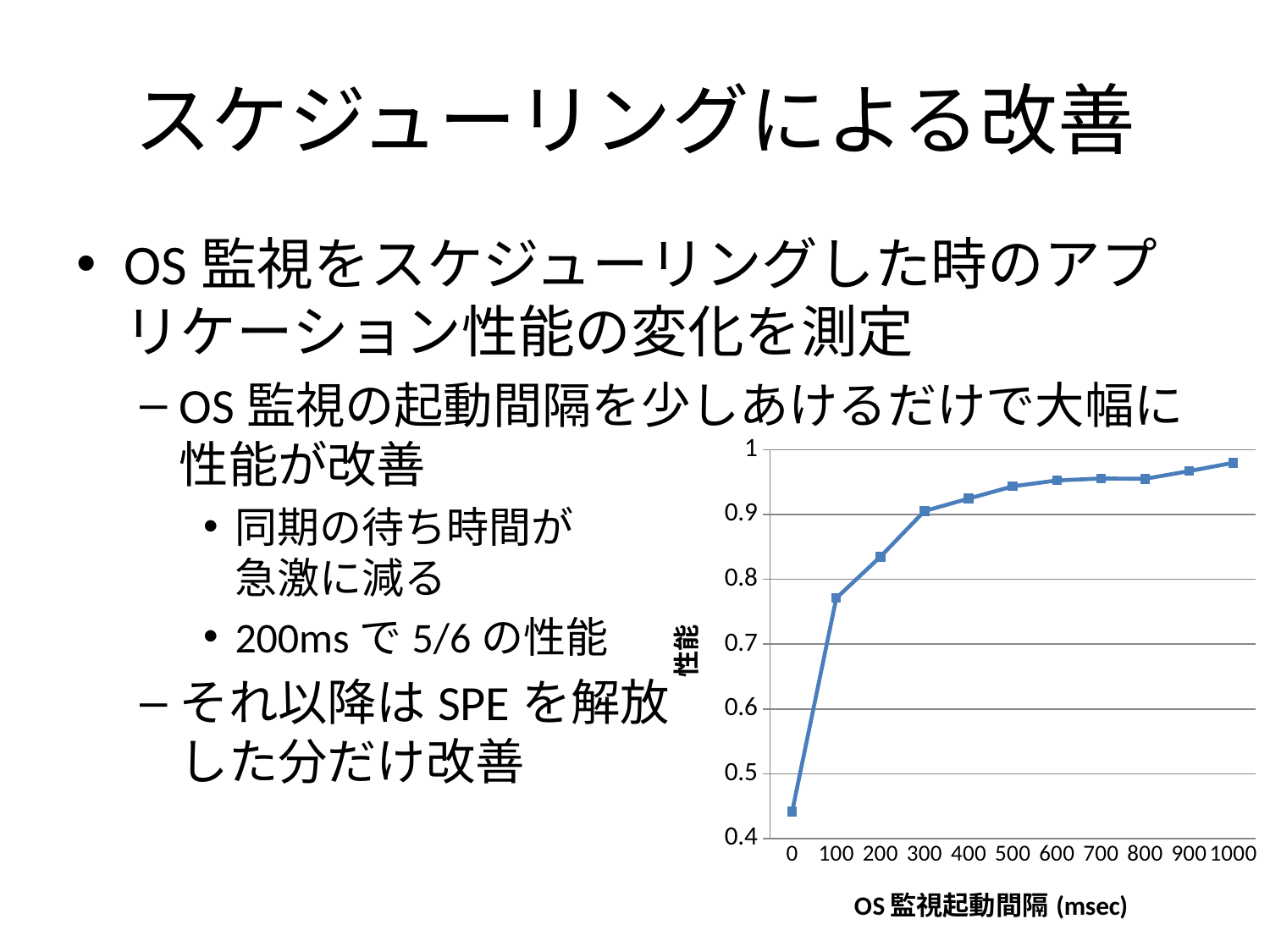
What is the title of the x axis of the chart? OS 監視起動間隔 (msec) Does the performance value rise or fall as the OS monitoring interval increases along the x axis? rise Which has the larger performance value, interval 100 or interval 200? 200 Is the performance value at interval 200 greater or less than 0.8? greater At which OS monitoring interval is the performance value highest? 1000 How many data points are plotted on the line? 11 What kind of chart is shown on the slide? line chart At which OS monitoring interval is the performance value lowest? 0 Is the performance value at interval 0 greater or less than 0.5? less Is the performance value at interval 100 greater or less than 0.7? greater What is the title of the y axis of the chart? 性能